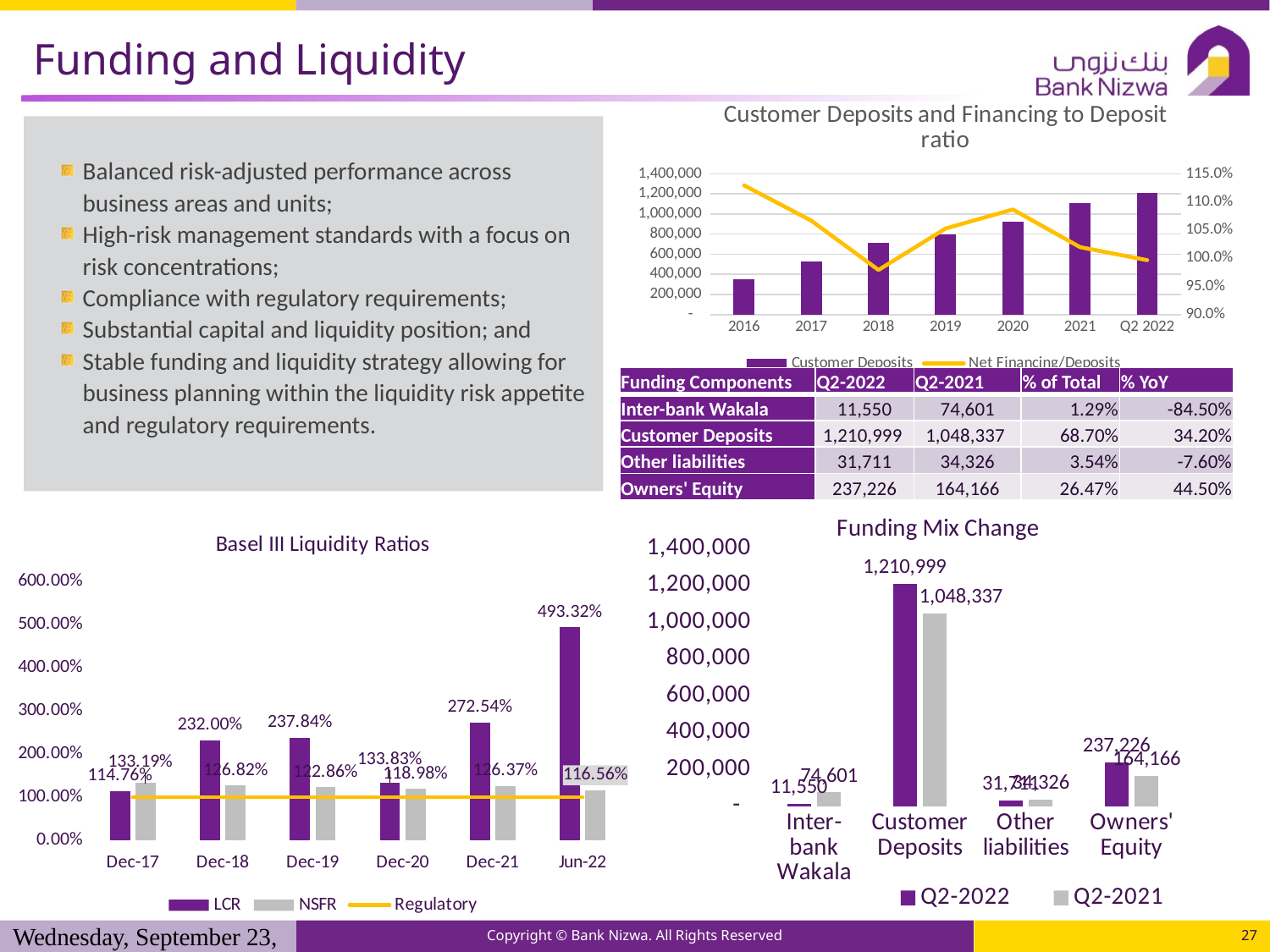
In the Funding Mix Change chart, what is the Q2-2021 value for Inter-bank Wakala? 74,601 In the Funding Mix Change chart, what is the Q2-2022 value for Customer Deposits? 1,210,999 In the Basel III Liquidity Ratios chart, which period has the lowest LCR? Dec-17 In the Basel III Liquidity Ratios chart, what is the NSFR value for Dec-20? 118.98% In the Funding Mix Change chart, how many categories are shown on the x axis? 4 In the Customer Deposits and Financing to Deposit ratio chart, is the Customer Deposits value for 2016 greater or less than 400,000? less In the Basel III Liquidity Ratios chart, what is the LCR value for Jun-22? 493.32% In the Funding Mix Change chart, which is larger for Other liabilities: Q2-2022 or Q2-2021? Q2-2021 In the Funding Mix Change chart, what is the difference between the Q2-2022 and Q2-2021 values for Owners' Equity? 73,060 In the Basel III Liquidity Ratios chart, which period has the highest LCR? Jun-22 In the Basel III Liquidity Ratios chart, how many series does the legend list? 3 In the Customer Deposits and Financing to Deposit ratio chart, do the Customer Deposits bars rise or fall from 2016 to Q2 2022? rise